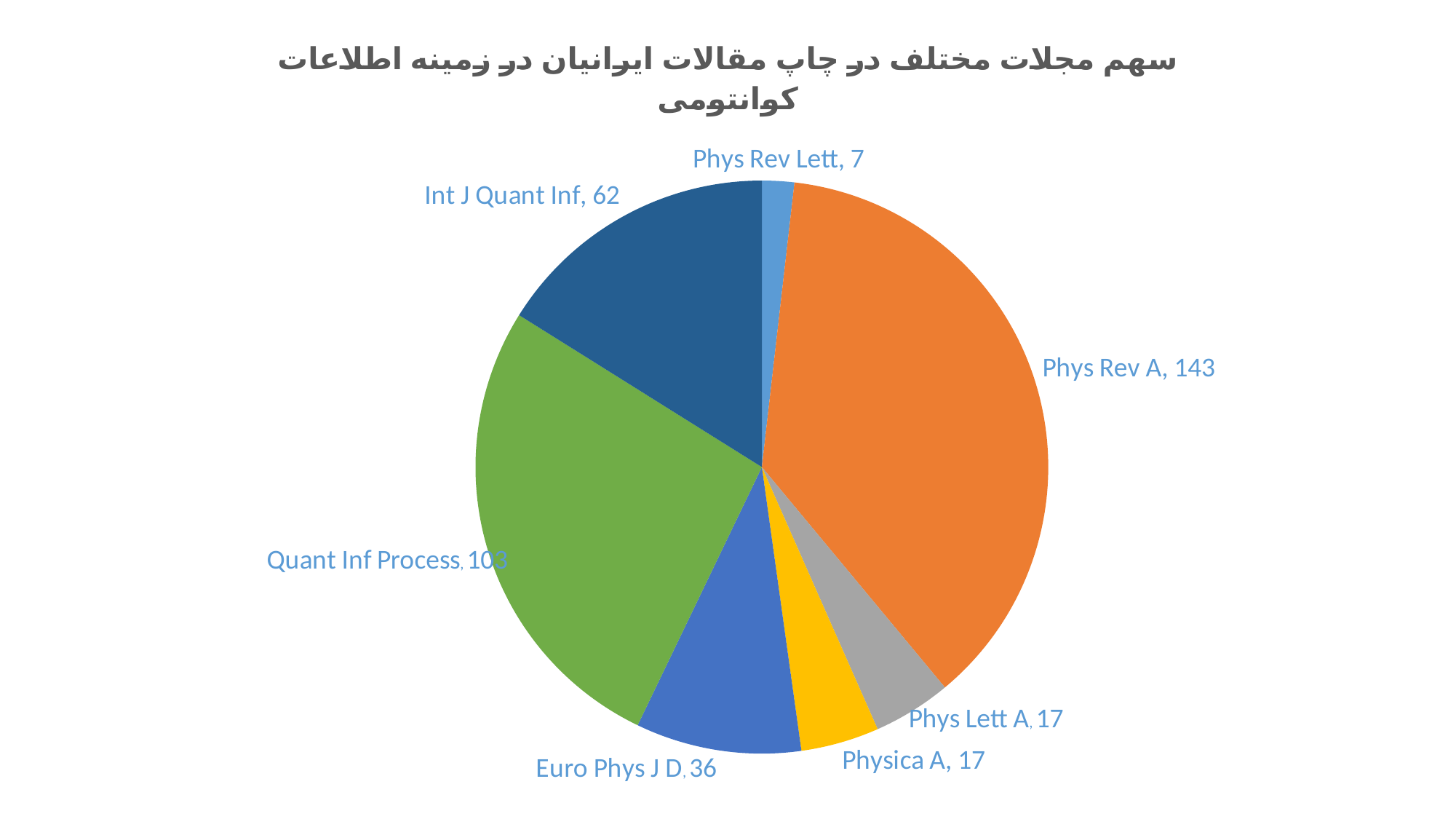
Which is larger, the value for Int J Quant Inf or the value for Euro Phys J D? Int J Quant Inf What is the value shown for Euro Phys J D? 36 What colour is the slice for Quant Inf Process? Green Which journal has the largest slice of the pie? Phys Rev A Which journal has the smallest slice of the pie? Phys Rev Lett What is the value shown for Quant Inf Process? 103 How many papers are attributed to Phys Rev A? 143 What is the difference between the values for Phys Rev A and Quant Inf Process? 40 What is the total of all the values shown in the pie chart? 385 What kind of chart is shown on the slide? Pie chart How many slices does the pie chart have? 7 What is the value shown for Int J Quant Inf? 62